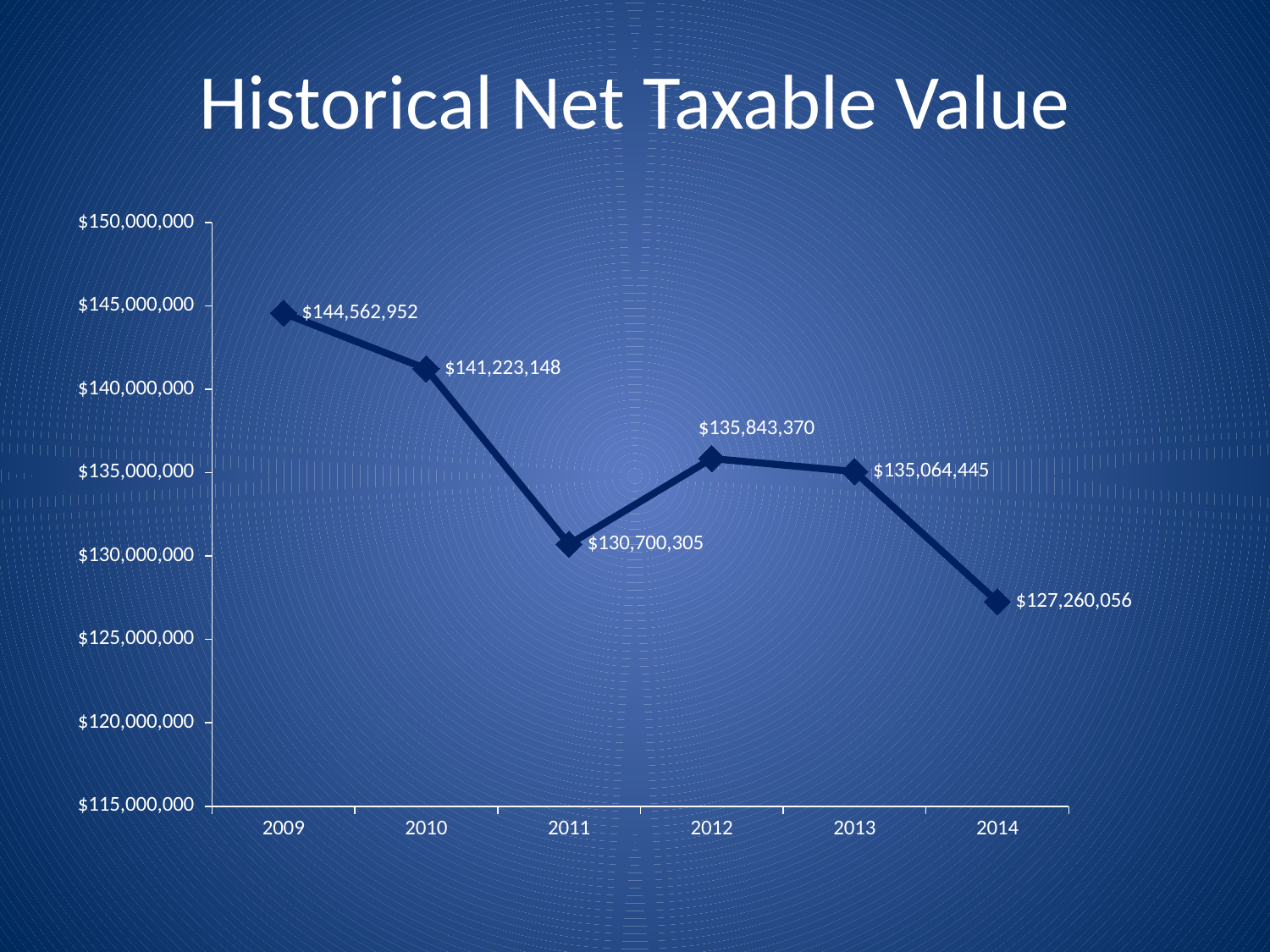
What kind of chart is shown on the slide? line chart Which year has the lowest net taxable value? 2014 Which year has the highest net taxable value? 2009 What is the net taxable value for 2011? $130,700,305 What is the net taxable value for 2014? $127,260,056 How many years are plotted on the chart? 6 Which year has the larger net taxable value, 2012 or 2013? 2012 What is the difference between the 2009 and 2010 net taxable values? $3,339,804 Is the value for 2011 greater or less than $135,000,000? less What is the net taxable value for 2009? $144,562,952 What is the difference between the 2012 and 2013 net taxable values? $778,925 What is the title of the chart? Historical Net Taxable Value